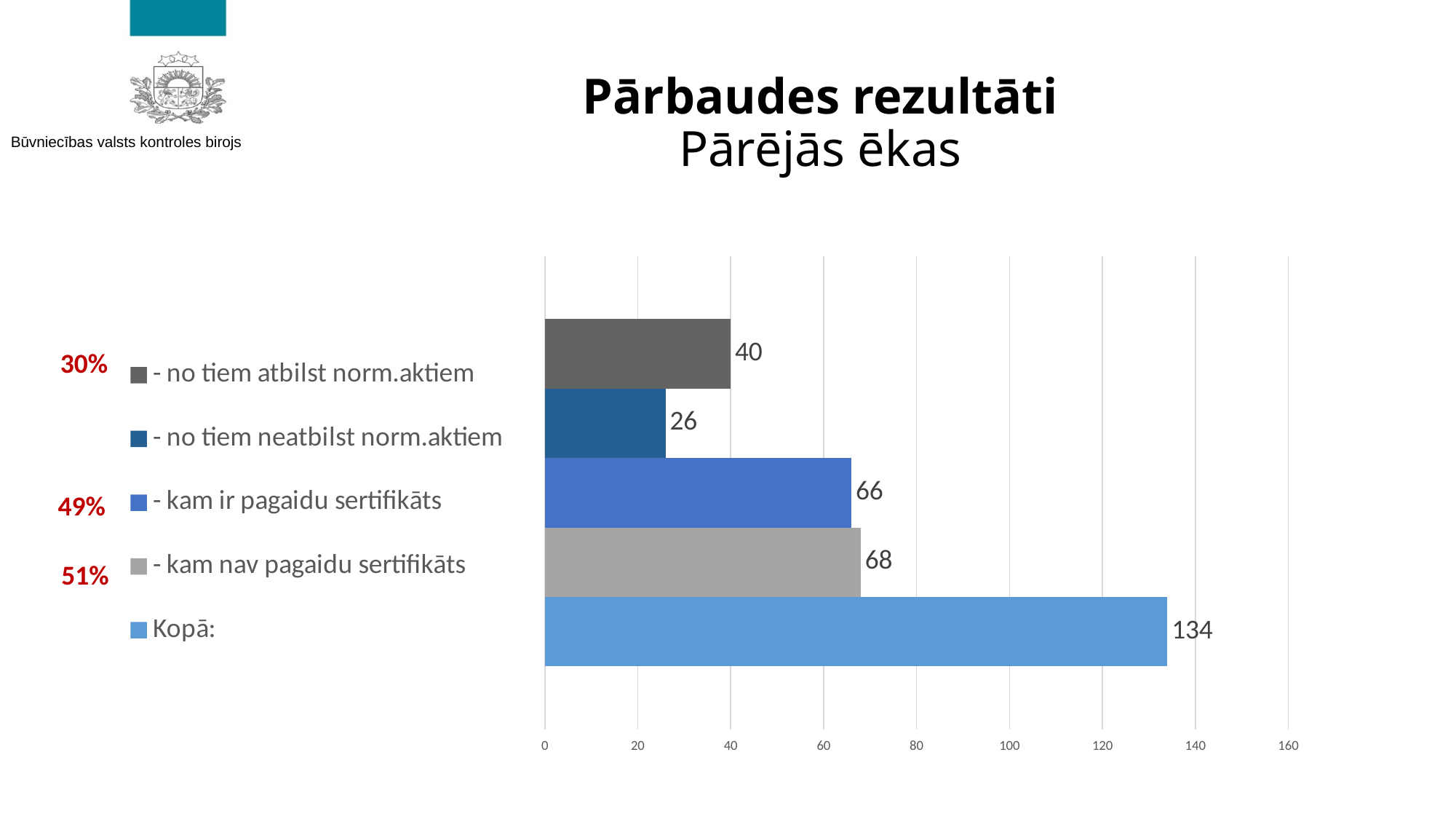
How many series does the legend list? 5 What is the value for "- kam ir pagaidu sertifikāts"? 66 What is the difference between the values for "- kam nav pagaidu sertifikāts" and "- kam ir pagaidu sertifikāts"? 2 What kind of chart is shown on the slide? bar chart What is the value for "- no tiem neatbilst norm.aktiem"? 26 Which is larger: the value for "- no tiem atbilst norm.aktiem" or "- no tiem neatbilst norm.aktiem"? - no tiem atbilst norm.aktiem Is the value for "Kopā:" greater or less than 120? greater Which series has the lowest value? - no tiem neatbilst norm.aktiem Which series has the highest value? Kopā: What is the title of the slide? Pārbaudes rezultāti Pārējās ēkas What is the value for "Kopā:"? 134 What is the value for "- no tiem atbilst norm.aktiem"? 40